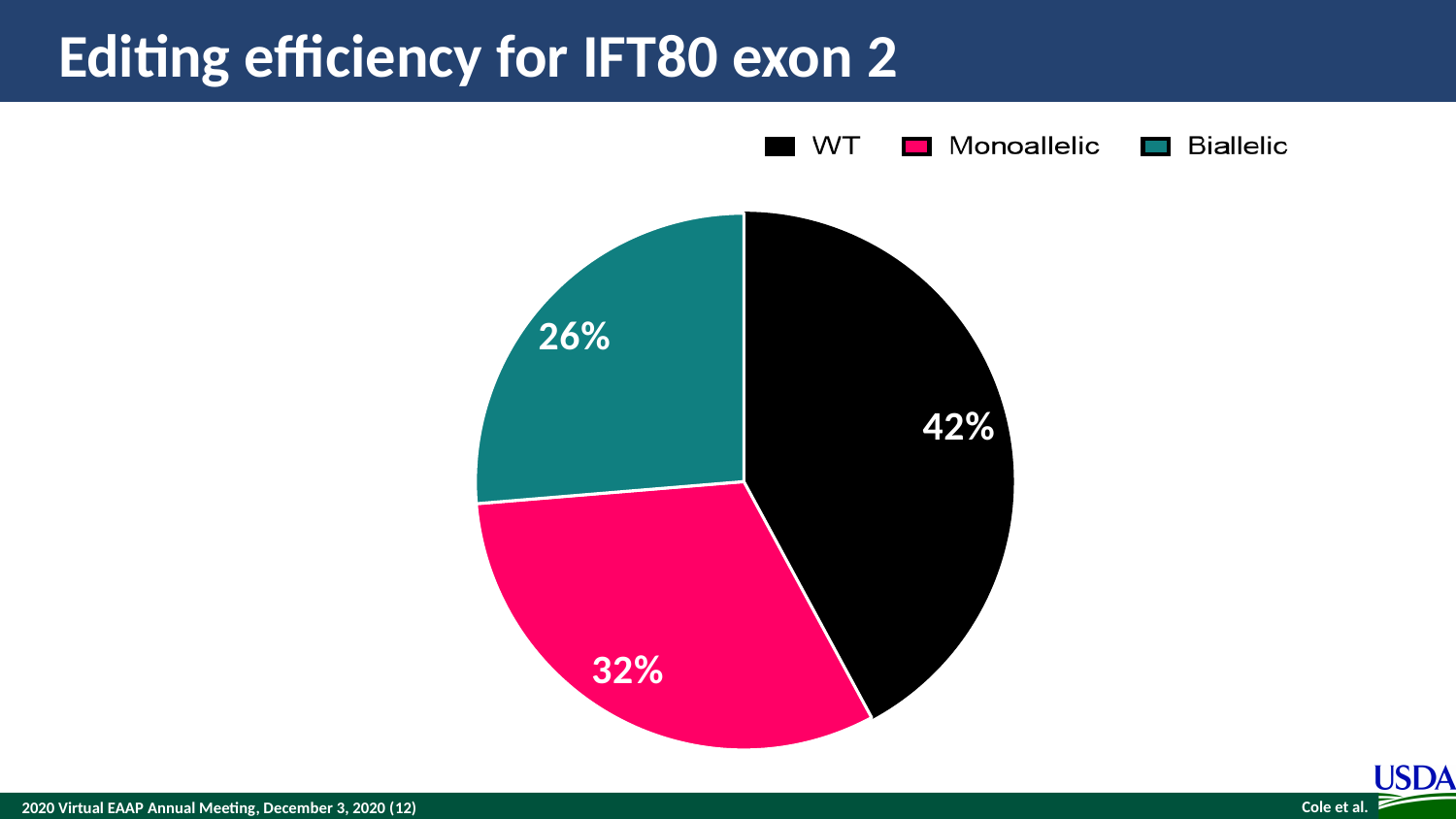
What percentage of the pie is labelled WT? 42% What is the difference in percentage points between the WT and Biallelic slices? 16 Which slice is larger, Monoallelic or Biallelic? Monoallelic Which category has the smallest slice of the pie? Biallelic How many entries does the legend list? 3 What percentage of the pie is labelled Biallelic? 26% What colour is the Monoallelic slice? pink Which category has the largest slice of the pie? WT What kind of chart is shown on the slide? pie chart What is the difference in percentage points between the Monoallelic and Biallelic slices? 6 What percentage of the pie is labelled Monoallelic? 32% How many slices does the pie chart have? 3